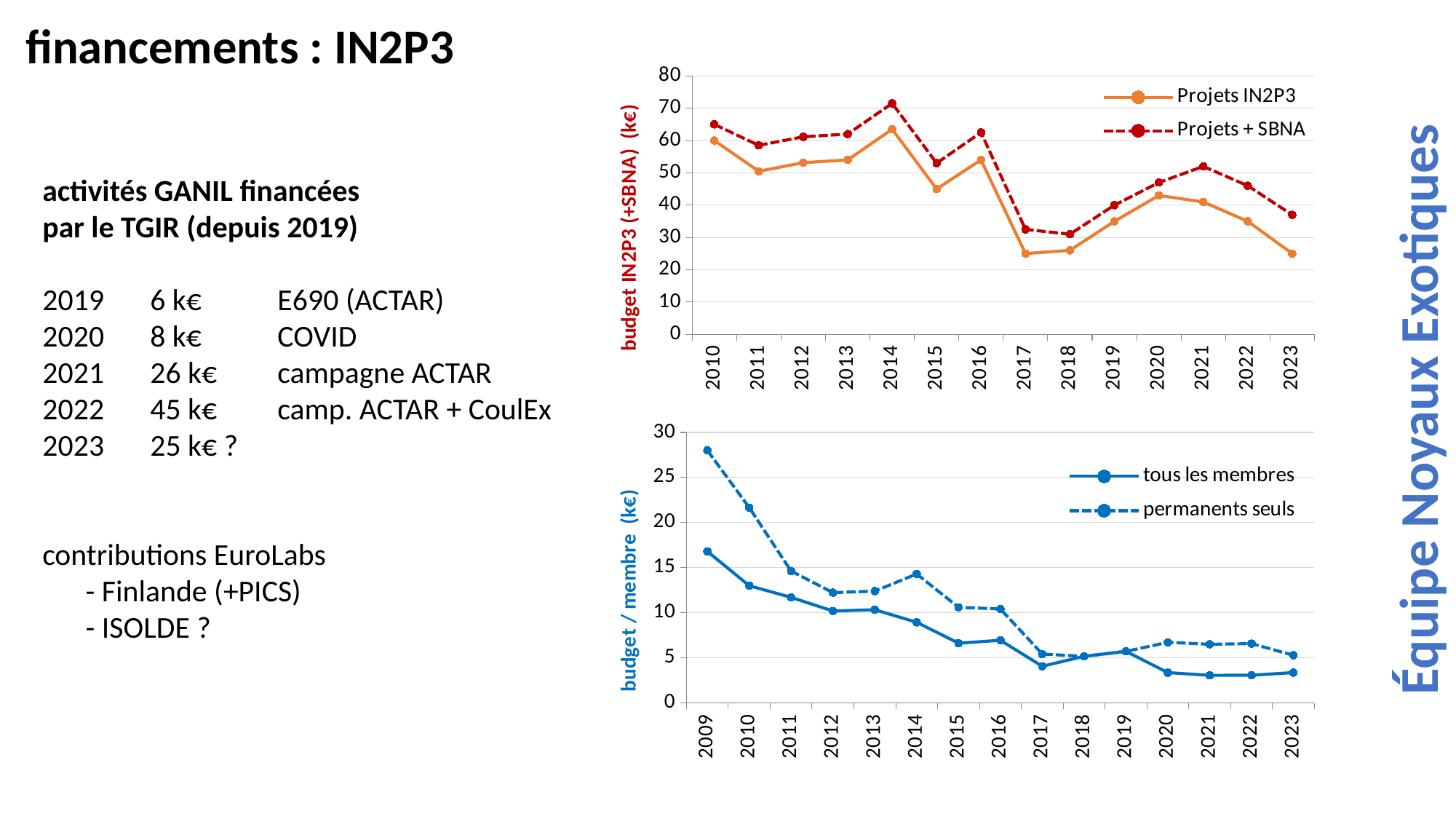
In the top chart (budget IN2P3 (+SBNA)), is the value for Projets + SBNA in 2021 greater or less than 50? greater In the bottom chart (budget / membre), is the value for permanents seuls in 2009 greater or less than 25? greater In the bottom chart (budget / membre), which is larger in 2014: tous les membres or permanents seuls? permanents seuls In the top chart (budget IN2P3 (+SBNA)), which year has the highest value for Projets IN2P3? 2014 In the bottom chart (budget / membre), how many years are shown on the x axis? 15 How many series does the legend of the top chart (budget IN2P3 (+SBNA)) list? 2 In the bottom chart (budget / membre), do the values for tous les membres generally rise or fall from 2009 to 2023? fall In the top chart (budget IN2P3 (+SBNA)), how many years are shown on the x axis? 14 In the top chart (budget IN2P3 (+SBNA)), is the value for Projets IN2P3 in 2017 greater or less than 30? less What kind of chart is the top chart (budget IN2P3 (+SBNA))? line chart In the top chart (budget IN2P3 (+SBNA)), which series is drawn with a dashed line? Projets + SBNA In the bottom chart (budget / membre), which year has the highest value for tous les membres? 2009